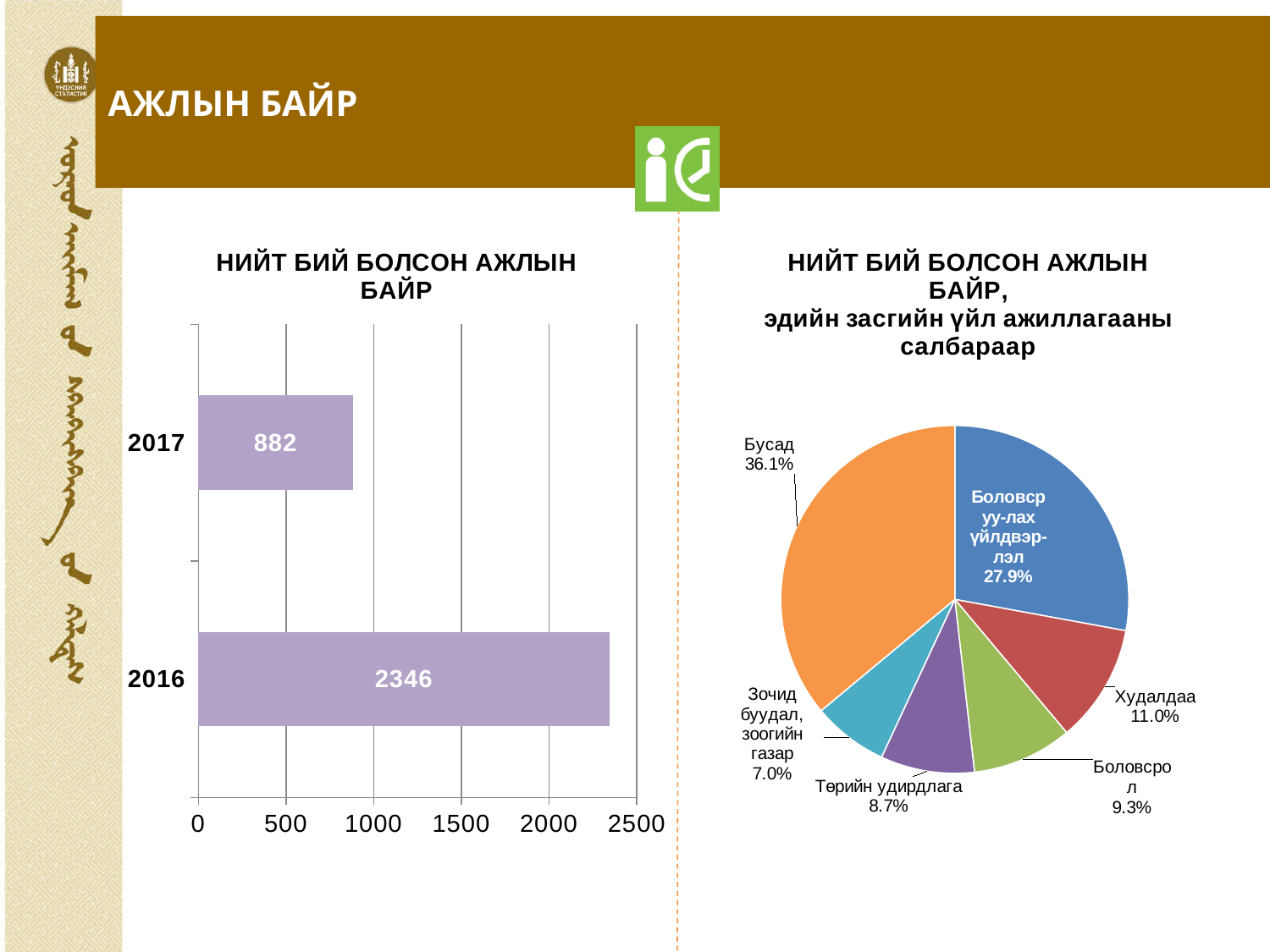
How many slices does the pie chart on the right have? 6 In the pie chart on the right, which slice is the smallest? Зочид буудал, зоогийн газар In the bar chart on the left, what is the value for 2017? 882 In the pie chart on the right, what share does Худалдаа have? 11.0% In the bar chart on the left, which year has the higher value? 2016 In the bar chart on the left, what is the difference between the 2016 and 2017 values? 1464 In the bar chart on the left, what is the value for 2016? 2346 In the pie chart on the right, what share does Төрийн удирдлага have? 8.7% In the pie chart on the right, which slice is the largest? Бусад In the bar chart on the left, is the value for 2016 greater or less than 2000? greater What kind of chart is the chart on the left of the slide? bar chart How many categories does the bar chart on the left show? 2